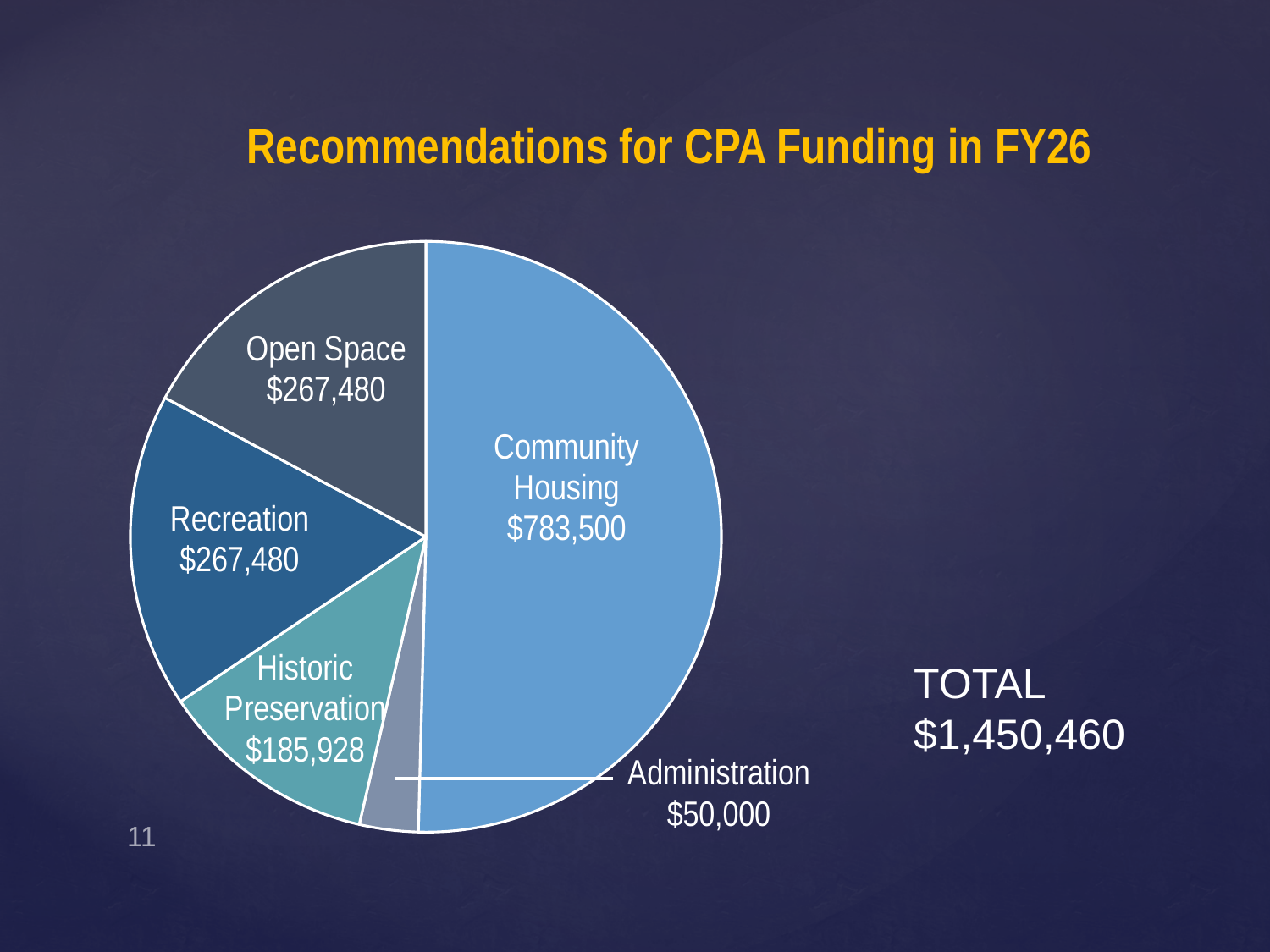
What is the value for Community Housing? $783,500 What kind of chart is shown on the slide? Pie chart How many categories are shown in the pie chart? 5 Which category receives the largest amount of funding? Community Housing What is the difference between the Historic Preservation and Administration values? $135,928 What is the value for Historic Preservation? $185,928 What is the title of the chart? Recommendations for CPA Funding in FY26 Which category receives the smallest amount of funding? Administration What is the value for Open Space? $267,480 What is the difference between the Community Housing and Open Space values? $516,020 What is the value for Administration? $50,000 Which is larger, Recreation or Historic Preservation? Recreation